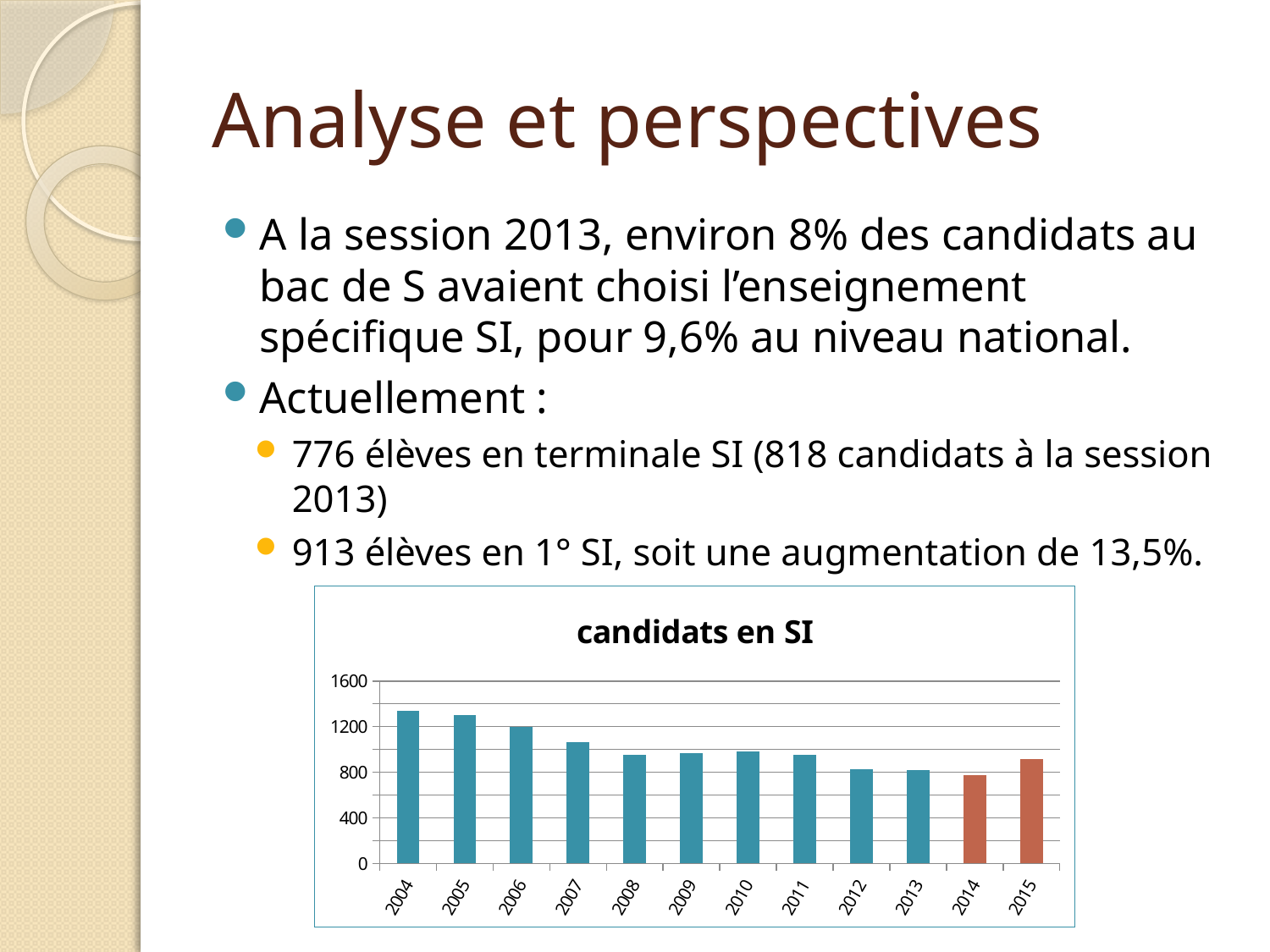
What kind of chart is shown on the slide? bar chart Which is larger, the value for 2004 or the value for 2015? 2004 Is the value for 2015 greater or less than 800? greater Is the value for 2008 greater or less than 1200? less Which year has the lowest number of candidats en SI? 2014 Which two years are shown with bars of a different colour from the rest? 2014 and 2015 How many years are shown on the x axis of the chart? 12 Do the values rise or fall from 2004 to 2008? fall Is the value for 2004 greater or less than 1200? greater What is the title of the chart? candidats en SI Which year has the highest number of candidats en SI? 2004